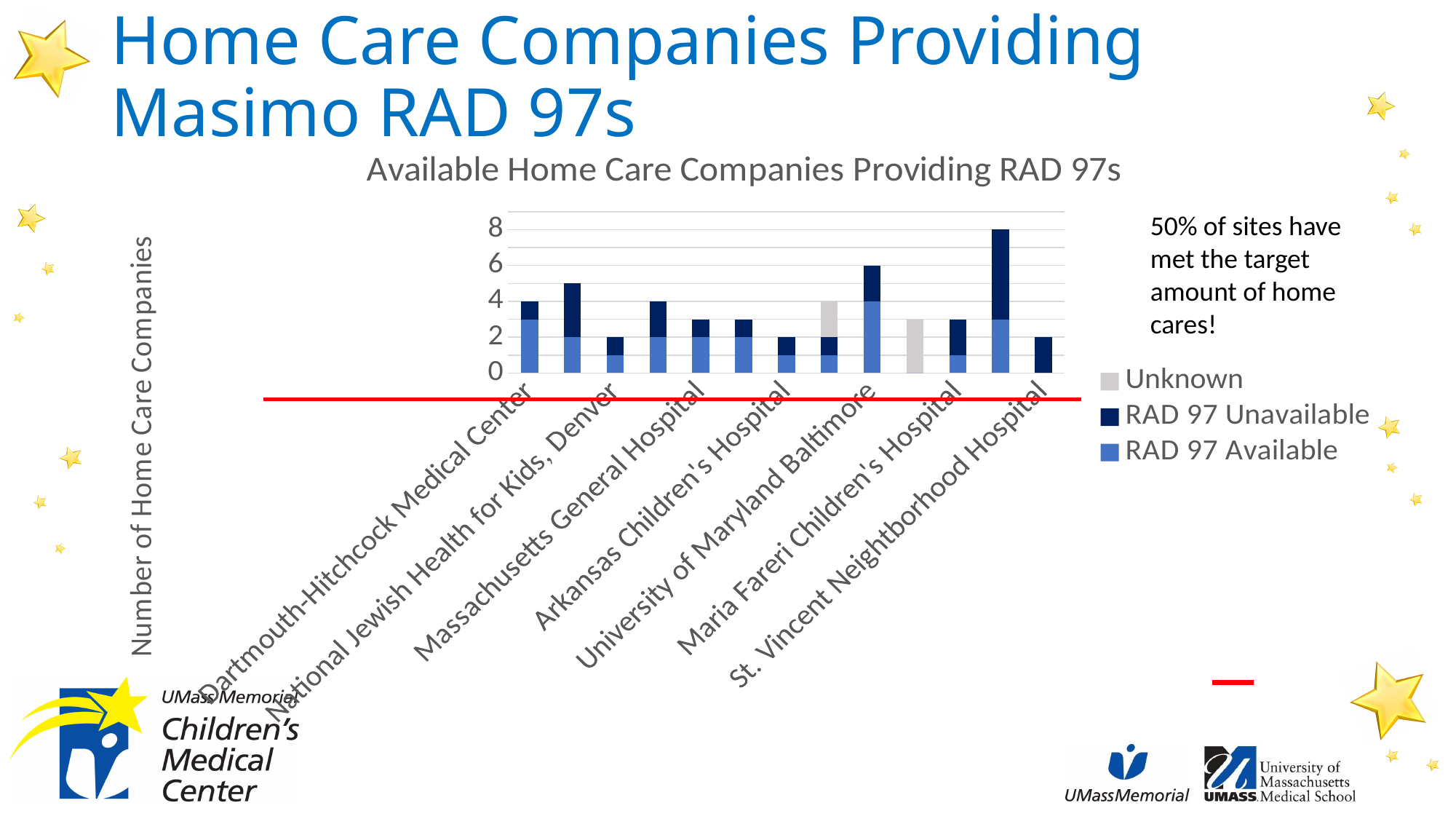
What is the highest value reached by any bar in the chart? 8 How many bars are plotted in the chart? 13 What is the label of the vertical axis? Number of Home Care Companies How many series does the chart legend list? 3 Which series is shown in grey in the legend? Unknown What is the total height of the bar for Dartmouth-Hitchcock Medical Center? 4 Is the total for Dartmouth-Hitchcock Medical Center greater or less than 2? greater Is the total for University of Maryland Baltimore greater or less than 4? greater What is the title of the chart? Available Home Care Companies Providing RAD 97s What is the total height of the bar for University of Maryland Baltimore? 6 What kind of chart is shown on the slide? Stacked bar chart Which is larger, the total for University of Maryland Baltimore or the total for Dartmouth-Hitchcock Medical Center? University of Maryland Baltimore